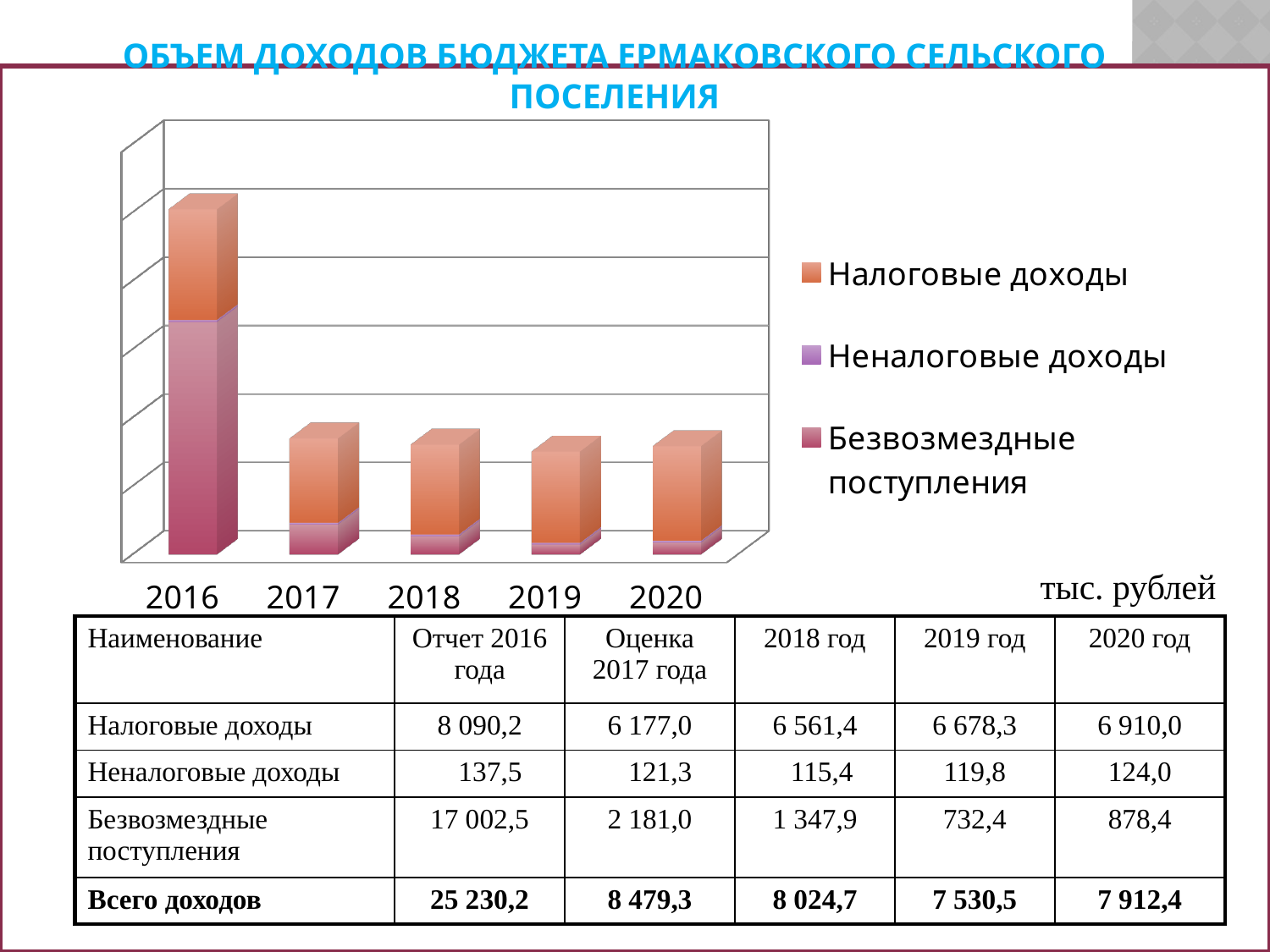
What is the difference between Налоговые доходы in 2020 and in 2017? 733,0 What kind of chart is shown on the slide? Stacked bar chart What is the value of Безвозмездные поступления for 2020? 878,4 Which year has the highest total income (Всего доходов)? 2016 In what units are the values on the slide given? тыс. рублей Which year has the lowest total income (Всего доходов)? 2019 What is the value of Налоговые доходы for 2016? 8 090,2 Do the values of Безвозмездные поступления rise or fall from 2016 to 2019? Fall What is the total of the stacked bar for 2018? 8 024,7 How many years (categories) are plotted on the x axis of the chart? 5 Which is larger: Безвозмездные поступления in 2019 or in 2020? 2020 How many series does the chart legend list? 3